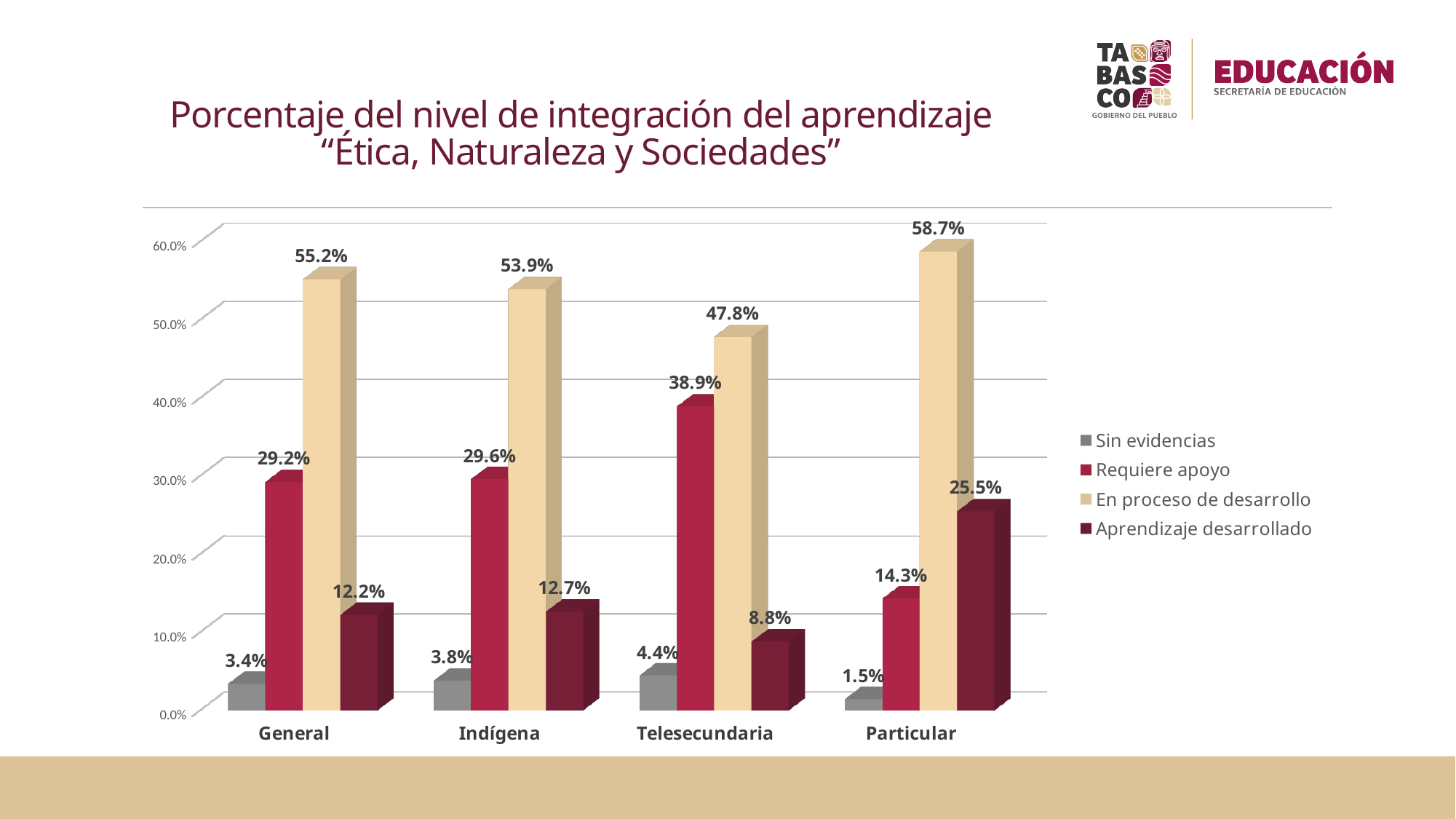
Which is larger: "Aprendizaje desarrollado" for Indígena or for Telesecundaria? Indígena What is the value for "Aprendizaje desarrollado" in the Particular category? 25.5% What is the value for "Sin evidencias" in the Indígena category? 3.8% How many series does the legend list? 4 Which category has the lowest value for "Sin evidencias"? Particular What is the difference between the "Requiere apoyo" values for Telesecundaria and Particular? 24.6% What is the value for "En proceso de desarrollo" in the General category? 55.2% Which category has the highest value for "En proceso de desarrollo"? Particular What is the value for "Requiere apoyo" in the Telesecundaria category? 38.9% How many categories are shown on the x axis? 4 What kind of chart is shown on the slide? Bar chart Which series is shown in the light beige colour? En proceso de desarrollo